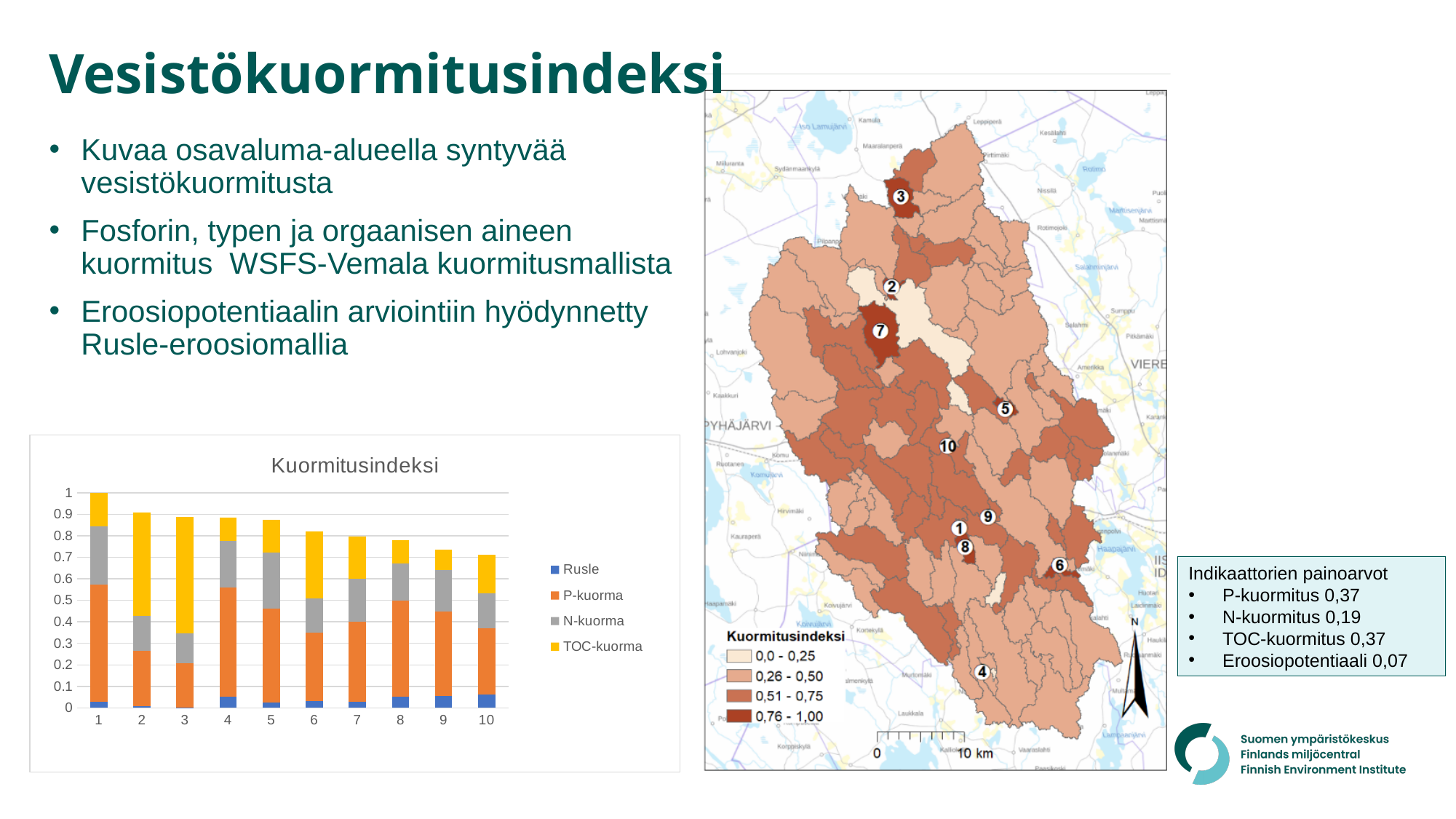
Is the total stacked value for category 9 greater or less than 0.8? less Which colour represents the TOC-kuorma series in the chart? Yellow Which category has the lowest total stacked bar in the chart? 10 Which has a larger total stacked value, category 1 or category 10? 1 Do the total stacked values generally rise or fall from category 1 to category 10? fall What is the title of the chart on the slide? Kuormitusindeksi How many categories are shown on the x axis of the chart? 10 Is the total stacked value for category 5 greater or less than 0.8? greater How many series does the chart legend list? 4 What type of chart is shown on the slide? Stacked bar chart Which category has the highest total stacked bar in the chart? 1 Is the total stacked value for category 10 greater or less than 0.8? less